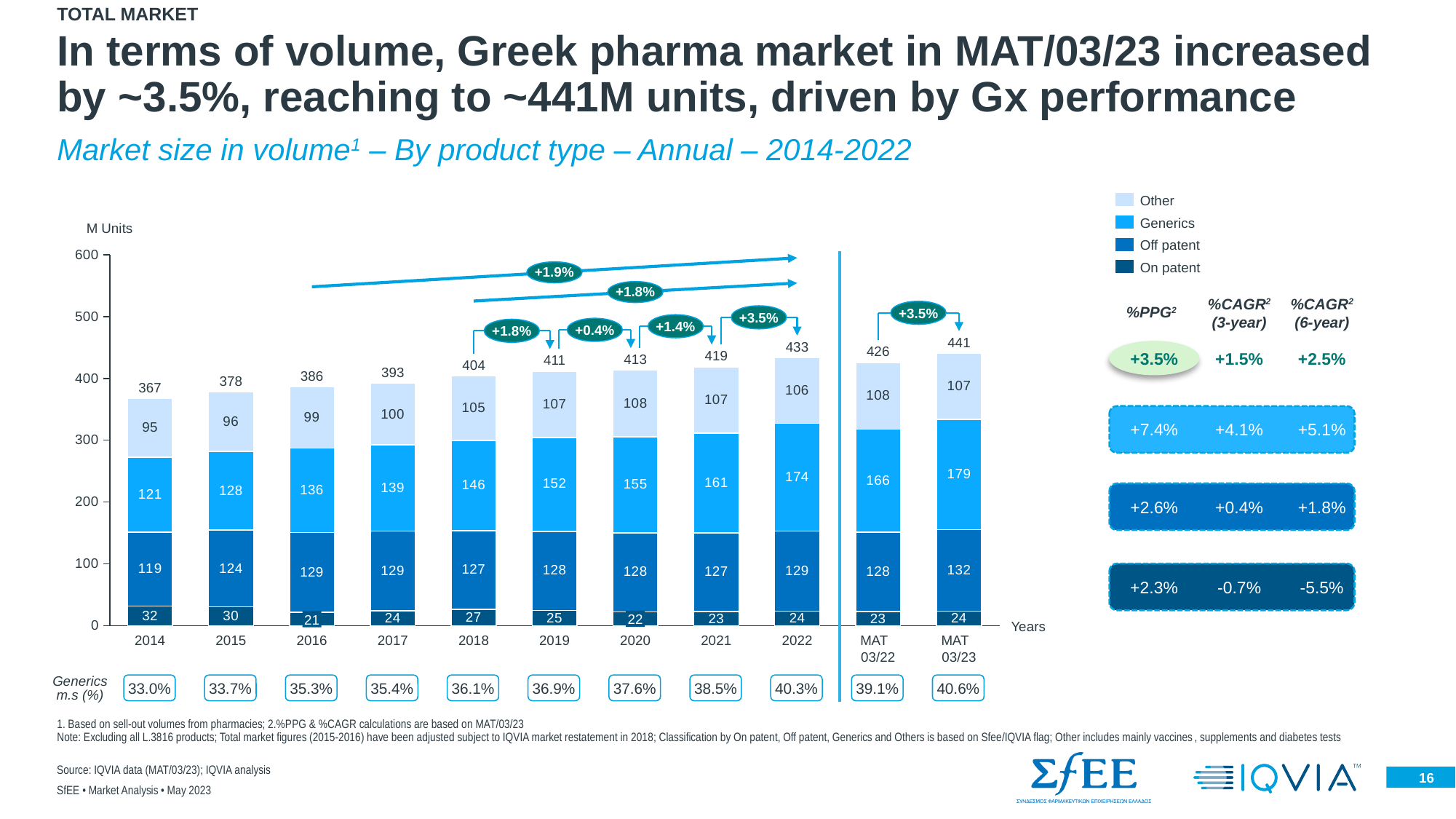
What is the difference between the Generics value in 2022 and in 2014? 53 Which bar has the lowest total market volume? 2014 In 2019, which is larger: the Generics value or the Off patent value? Generics What kind of chart is shown on the slide? Stacked bar chart How many series does the chart legend list? 4 Do the total market volumes rise or fall from 2014 to 2022? Rise What is the Generics market share (m.s %) shown for 2022? 40.3% How many bars are plotted in the chart (including the MAT bars)? 11 Which of the annual bars (2014-2022) has the highest total market volume? 2022 What is the Generics value for 2022? 174 What is the On patent value for 2016? 21 What is the total market volume for MAT 03/23? 441